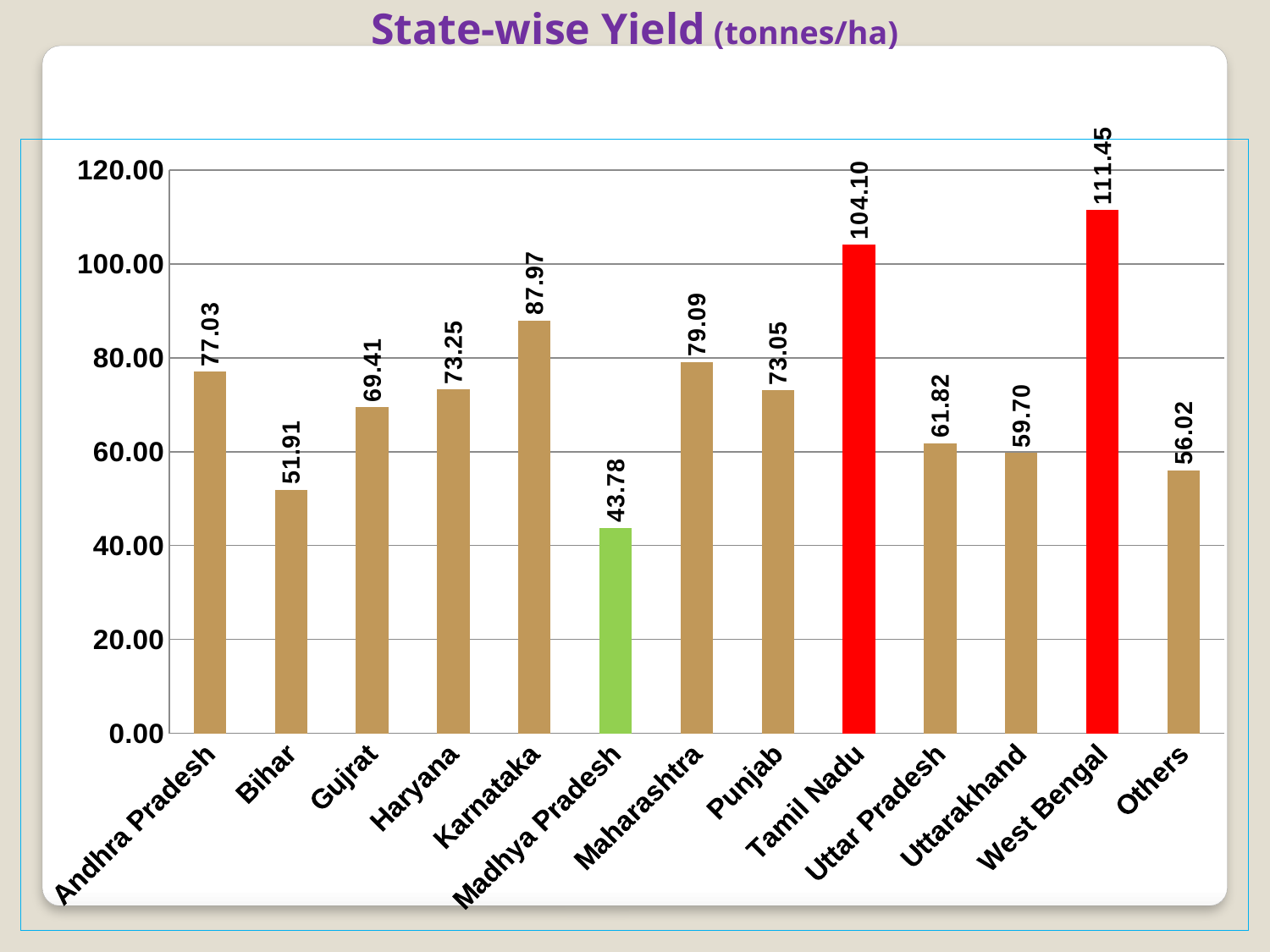
Which bar is coloured green? Madhya Pradesh Which state has the highest yield? West Bengal Which state has the lowest yield? Madhya Pradesh What kind of chart is this? bar chart How many categories are shown on the x axis? 13 What is the yield for Uttar Pradesh? 61.82 Is the value for Bihar greater or less than 60.00? less What is the difference between the yields of West Bengal and Tamil Nadu? 7.35 What is the yield for Karnataka? 87.97 What is the title of the chart? State-wise Yield (tonnes/ha) Which has a higher yield, Maharashtra or Punjab? Maharashtra What is the difference between the yields of Andhra Pradesh and Bihar? 25.12